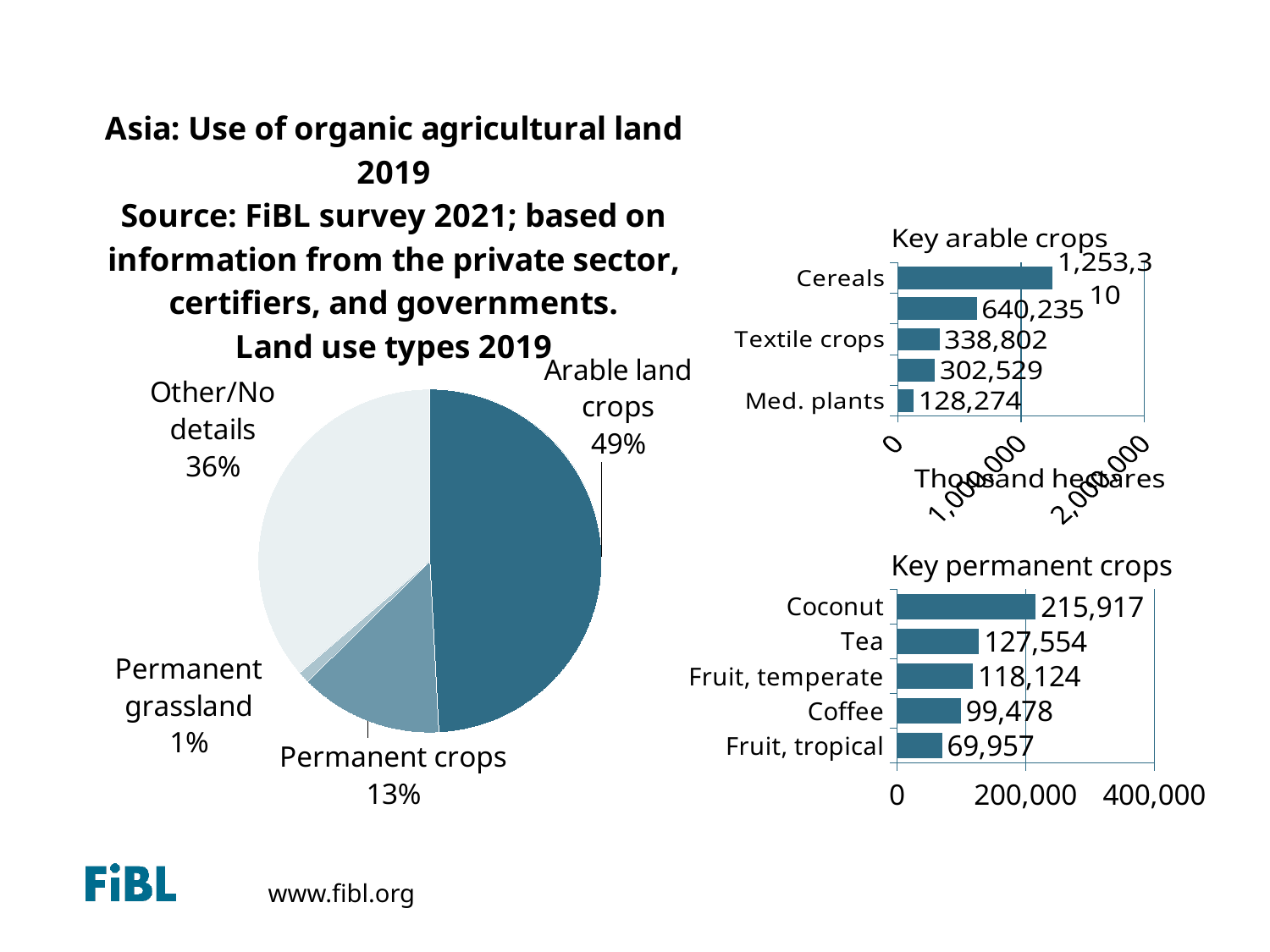
In the Key arable crops chart, is the value for Cereals greater or less than 1,000,000? greater How many crops are shown in the Key permanent crops chart? 5 In the Key permanent crops chart, what is the value for Coconut? 215,917 In the Key arable crops chart, what is the value for Textile crops? 338,802 What kind of chart is the Key permanent crops chart? bar chart In the Land use types 2019 pie chart, which land use type has the smallest share? Permanent grassland In the Key permanent crops chart, what is the difference between Coconut and Tea? 88,363 In the Key permanent crops chart, which is larger, Tea or Coffee? Tea In the Land use types 2019 pie chart, what share is Arable land crops? 49% How many slices does the Land use types 2019 pie chart have? 4 In the Key permanent crops chart, which crop has the lowest value? Fruit, tropical In the Land use types 2019 pie chart, which land use type has the largest share? Arable land crops